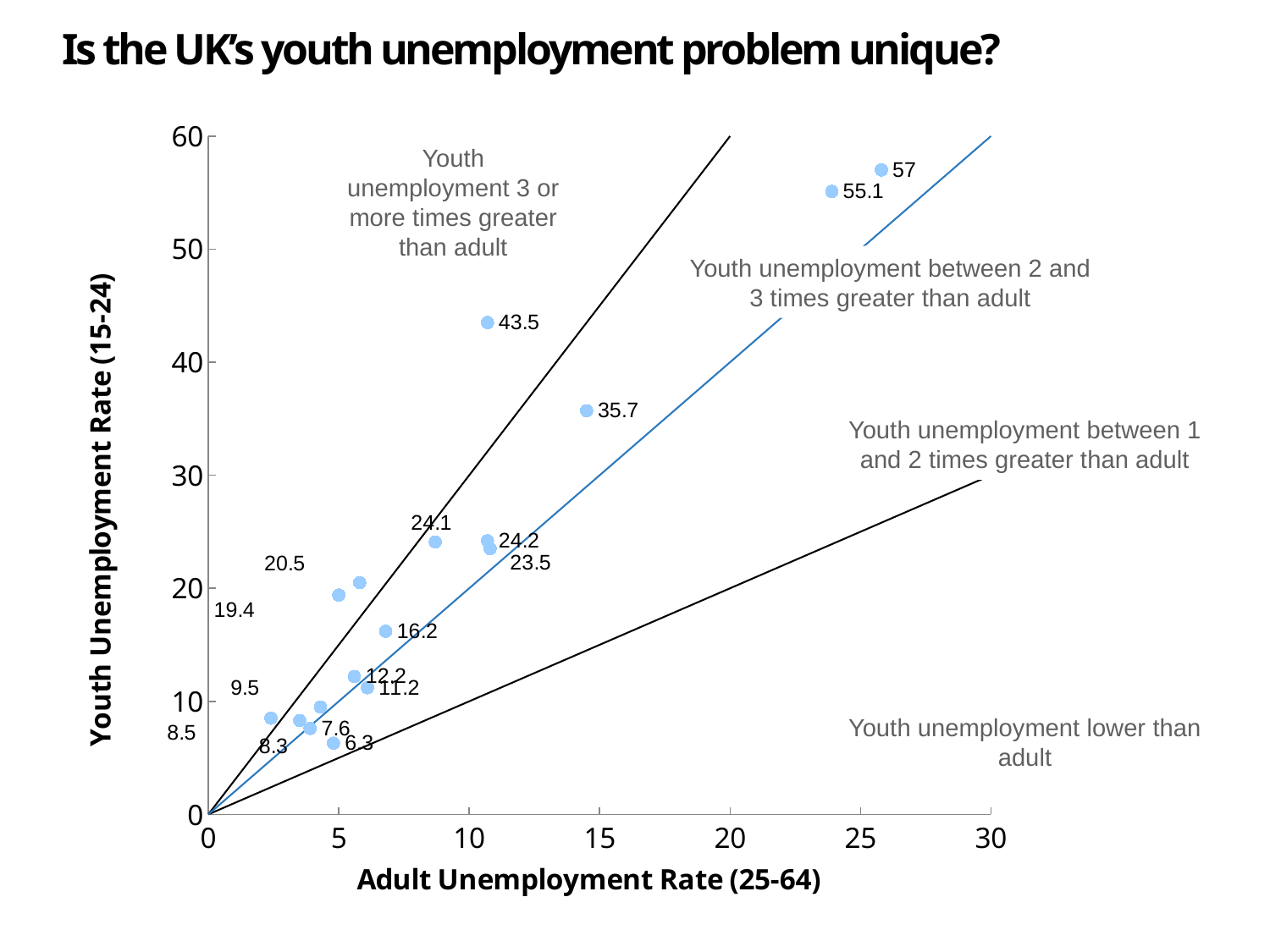
What type of chart is shown on the slide? scatter chart Which is larger, the point labelled 24.2 or the point labelled 23.5? 24.2 What is the title of the x axis? Adult Unemployment Rate (25-64) How many data points are plotted on the chart? 17 What is the lowest youth unemployment rate labelled on the chart? 6.3 Is the adult unemployment rate for the point labelled 16.2 greater or less than 5? greater What is the highest youth unemployment rate labelled on the chart? 57 What is the difference between the points labelled 43.5 and 35.7? 7.8 What is the title of the y axis? Youth Unemployment Rate (15-24) What is the difference between the two highest labelled youth unemployment rates, 57 and 55.1? 1.9 Is the adult unemployment rate for the point labelled 55.1 greater or less than 20? greater Is the adult unemployment rate for the point labelled 43.5 greater or less than 15? less